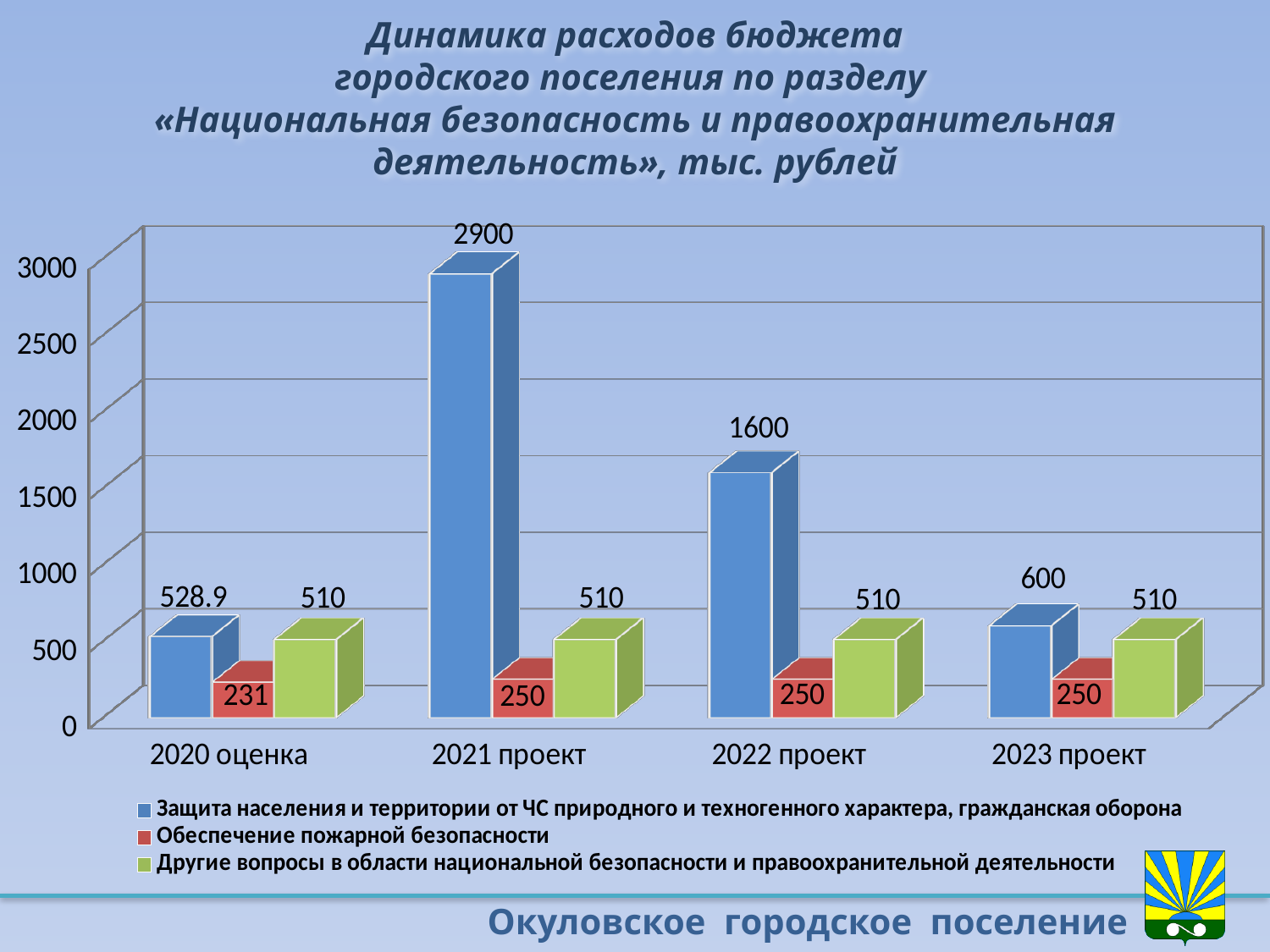
Каким цветом на диаграмме показана серия «Обеспечение пожарной безопасности»? Красным Какое значение показано для серии «Защита населения и территории от ЧС природного и техногенного характера, гражданская оборона» в категории «2021 проект»? 2900 Какой тип диаграммы показан на слайде? Столбчатая (bar chart) Сколько категорий показано на оси X диаграммы? 4 Какое значение показано для серии «Другие вопросы в области национальной безопасности и правоохранительной деятельности» в категории «2023 проект»? 510 Как изменяется значение серии «Защита населения и территории от ЧС природного и техногенного характера, гражданская оборона» от категории «2021 проект» к категории «2023 проект»? Снижается На сколько значение серии «Защита населения и территории от ЧС природного и техногенного характера, гражданская оборона» в категории «2021 проект» больше, чем в категории «2022 проект»? 1300 Какое значение показано для серии «Обеспечение пожарной безопасности» в категории «2020 оценка»? 231 В какой категории значение серии «Защита населения и территории от ЧС природного и техногенного характера, гражданская оборона» наименьшее? 2020 оценка Сколько серий перечислено в легенде диаграммы? 3 В какой категории значение серии «Защита населения и территории от ЧС природного и техногенного характера, гражданская оборона» наибольшее? 2021 проект Что больше: значение серии «Обеспечение пожарной безопасности» в категории «2020 оценка» или в категории «2021 проект»? 2021 проект